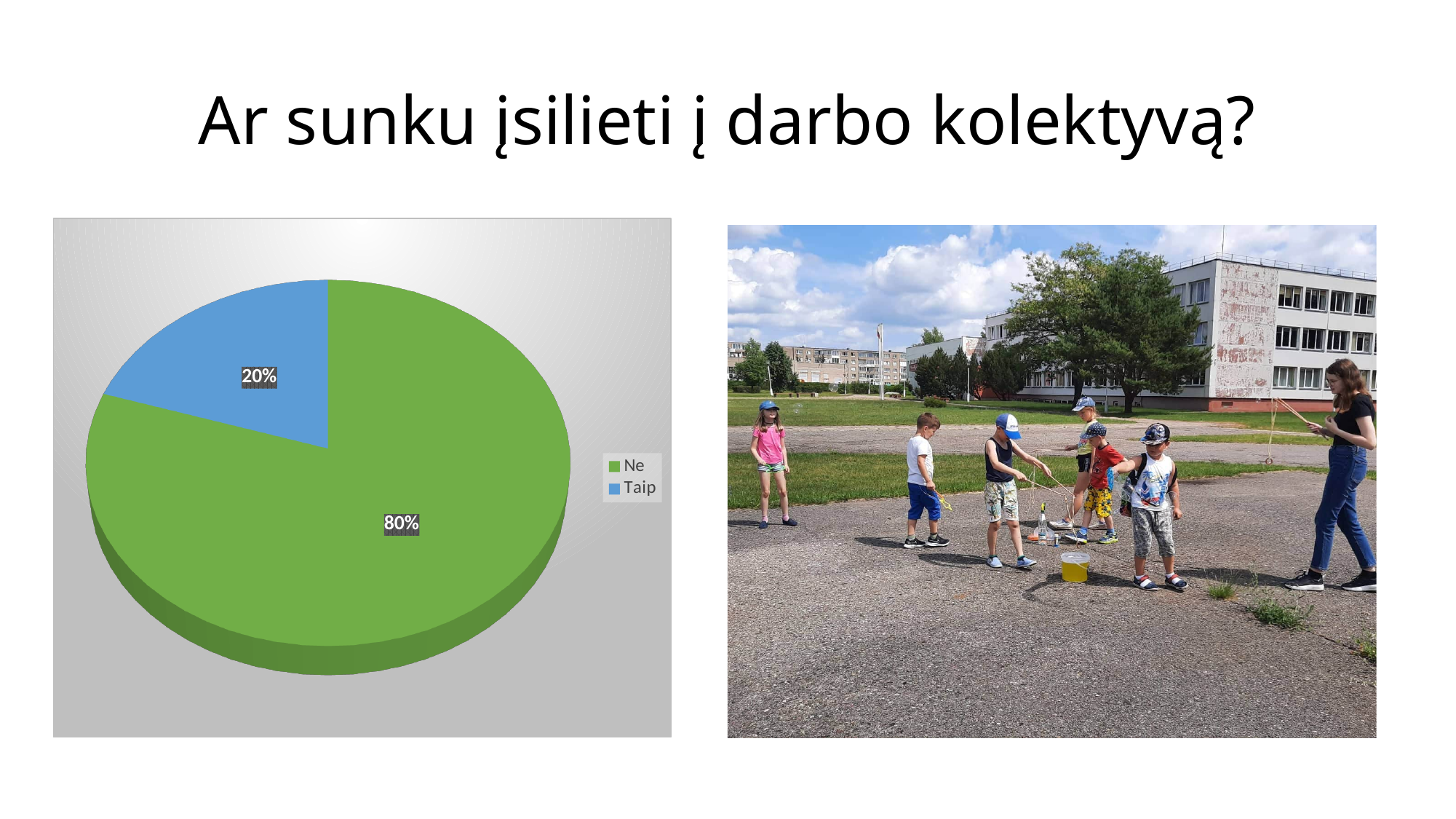
What kind of chart is shown on the slide? pie chart Which category has the largest slice of the pie? Ne How many categories does the pie chart show? 2 What colour is the "Ne" slice in the pie chart? green What share of the pie does the "Ne" slice represent? 80% What is the difference in percentage points between the "Ne" and "Taip" slices? 60 Which category has the smallest slice of the pie? Taip What share of the pie does the "Taip" slice represent? 20% Which is larger, the "Ne" slice or the "Taip" slice? Ne What colour is the "Taip" slice in the pie chart? blue